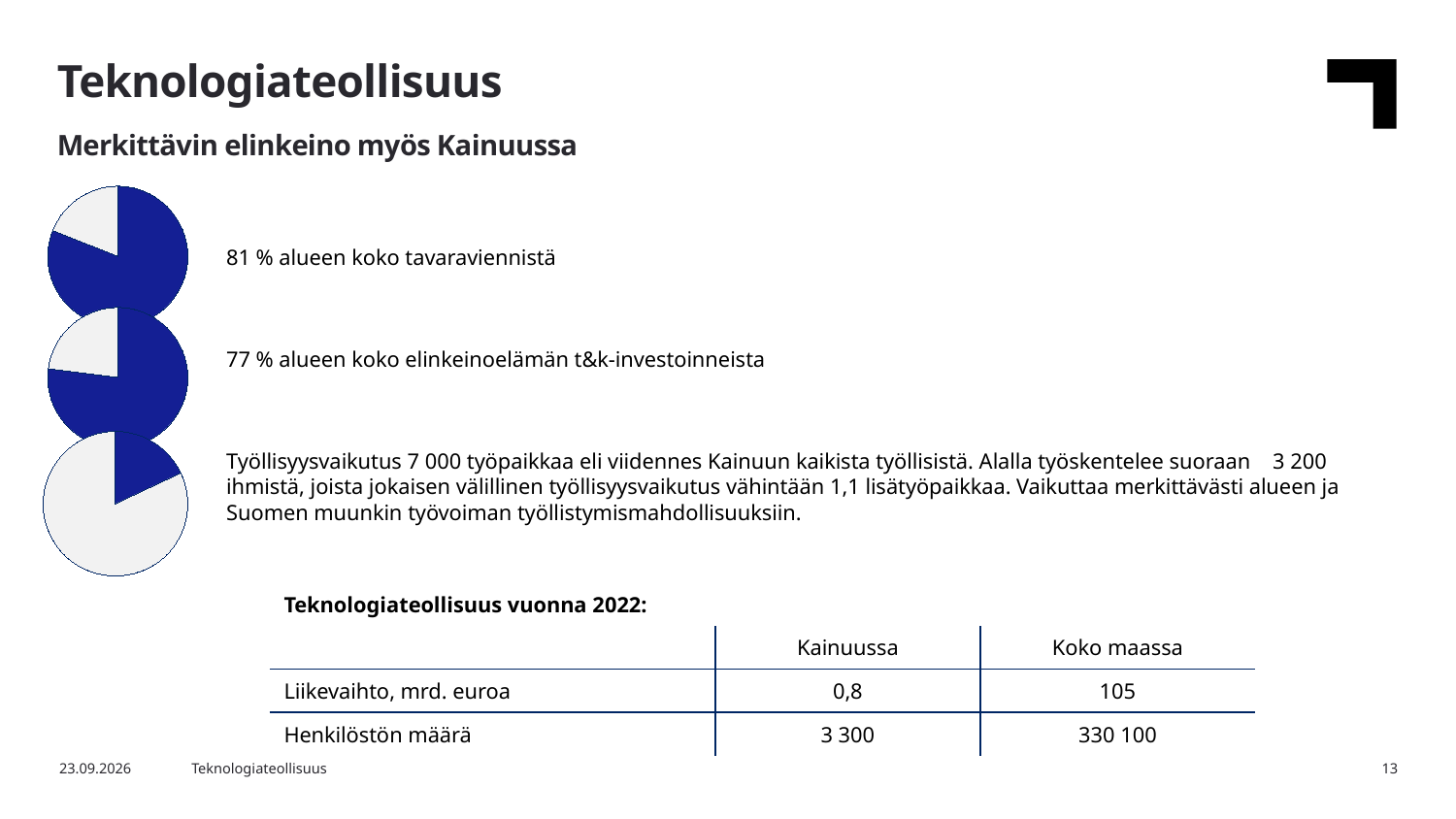
Is the blue slice in the bottom pie chart greater or less than 50%? Less What colour is the highlighted slice in each pie chart? Dark blue What does the bottom pie chart illustrate, according to the text beside it? The technology industry's employment effect as a fifth (viidennes) of all employed people in Kainuu What is the difference in percentage points between the share shown for the top pie chart (81 %) and the middle pie chart (77 %)? 4 percentage points What kind of charts are shown on the left side of the slide? Pie charts Which pie chart has a larger blue slice, the top one or the bottom one? The top one Which of the three pie charts has the smallest blue slice? The bottom one According to the text beside the middle pie chart, what share of the region's business R&D investments (t&k-investoinnit) does the technology industry account for? 77 % According to the text beside the top pie chart, what share of the region's total goods exports (tavaravienti) does the technology industry account for? 81 % How many pie charts are on the slide? 3 Which of the three pie charts has the largest blue slice? The top one Is the blue slice in the top pie chart greater or less than 50%? Greater